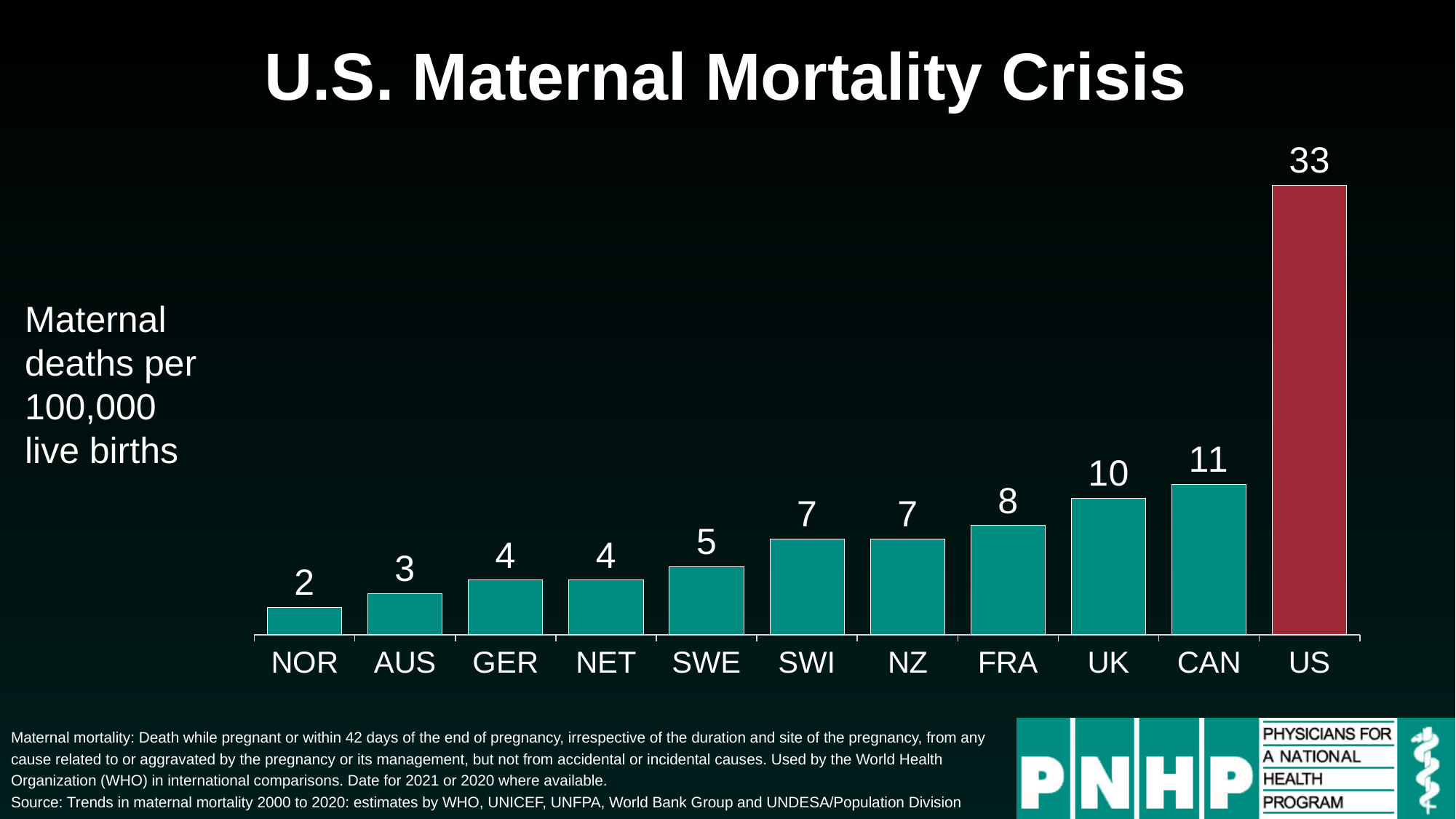
What is the value shown for CAN? 11 Which country has the lowest maternal mortality in the chart? NOR Which bar is coloured differently (red) from the others? US What is the difference between the values for UK and NOR? 8 How many countries are shown in the chart? 11 Do the values generally rise or fall from left to right across the countries? Rise Which country has the highest maternal mortality in the chart? US What is the maternal mortality value shown for the US? 33 What is the difference between the values for the US and CAN? 22 Which has a higher value, FRA or AUS? FRA What kind of chart is shown on the slide? Bar chart What is the value shown for SWE? 5